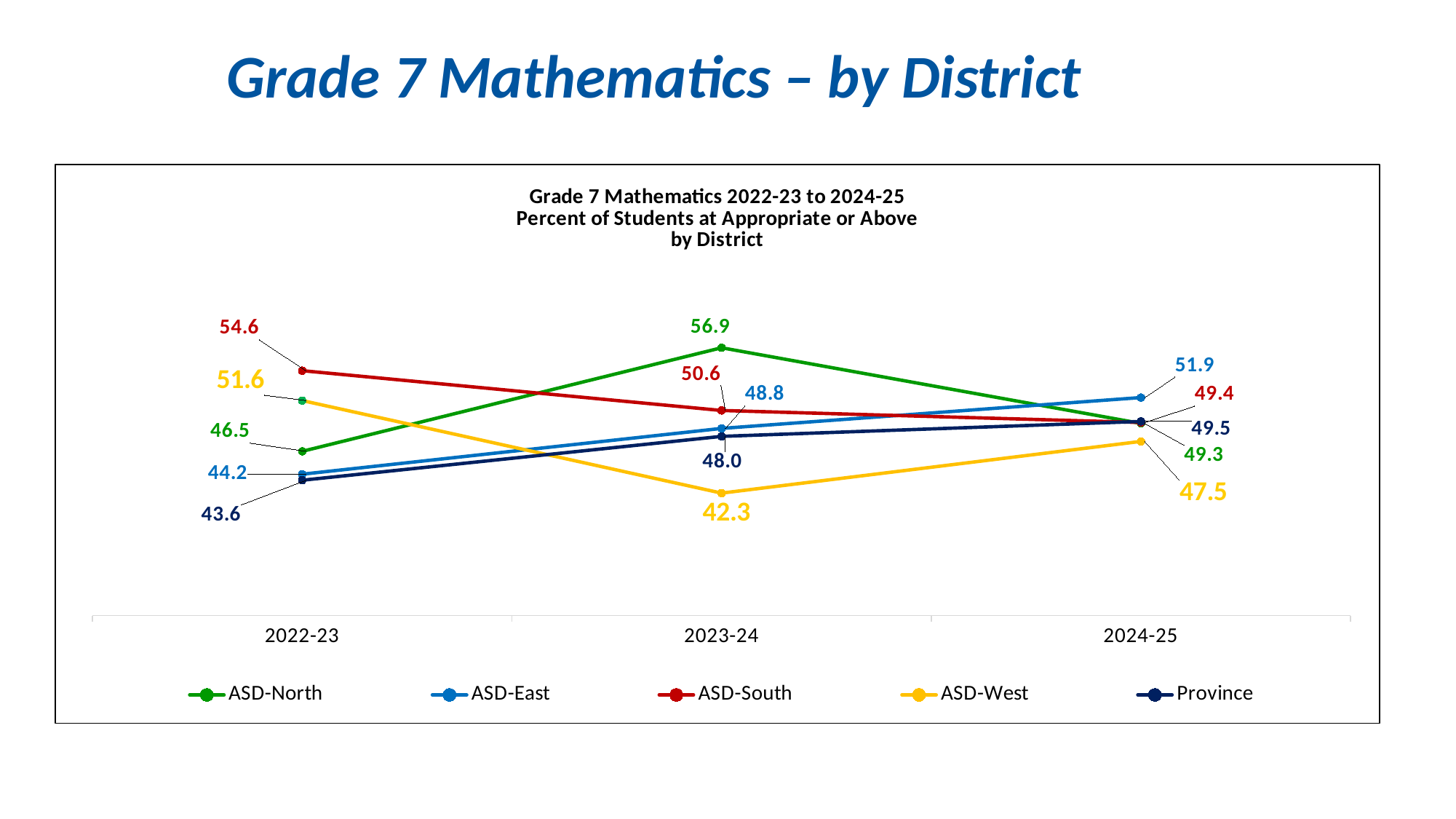
Which district has the highest value in 2023-24? ASD-North Do the Province values rise or fall from 2022-23 to 2024-25? rise What is the value for ASD-West in 2024-25? 47.5 Which is larger in 2022-23, ASD-West or ASD-North? ASD-West What is the value for ASD-South in 2022-23? 54.6 What is the difference between ASD-East's values in 2024-25 and 2022-23? 7.7 How many school years are shown on the x axis? 3 What is the value for ASD-North in 2023-24? 56.9 What is the value for Province in 2022-23? 43.6 What type of chart is shown on the slide? line chart Which series has the lowest value in 2023-24? ASD-West How many series does the legend list? 5